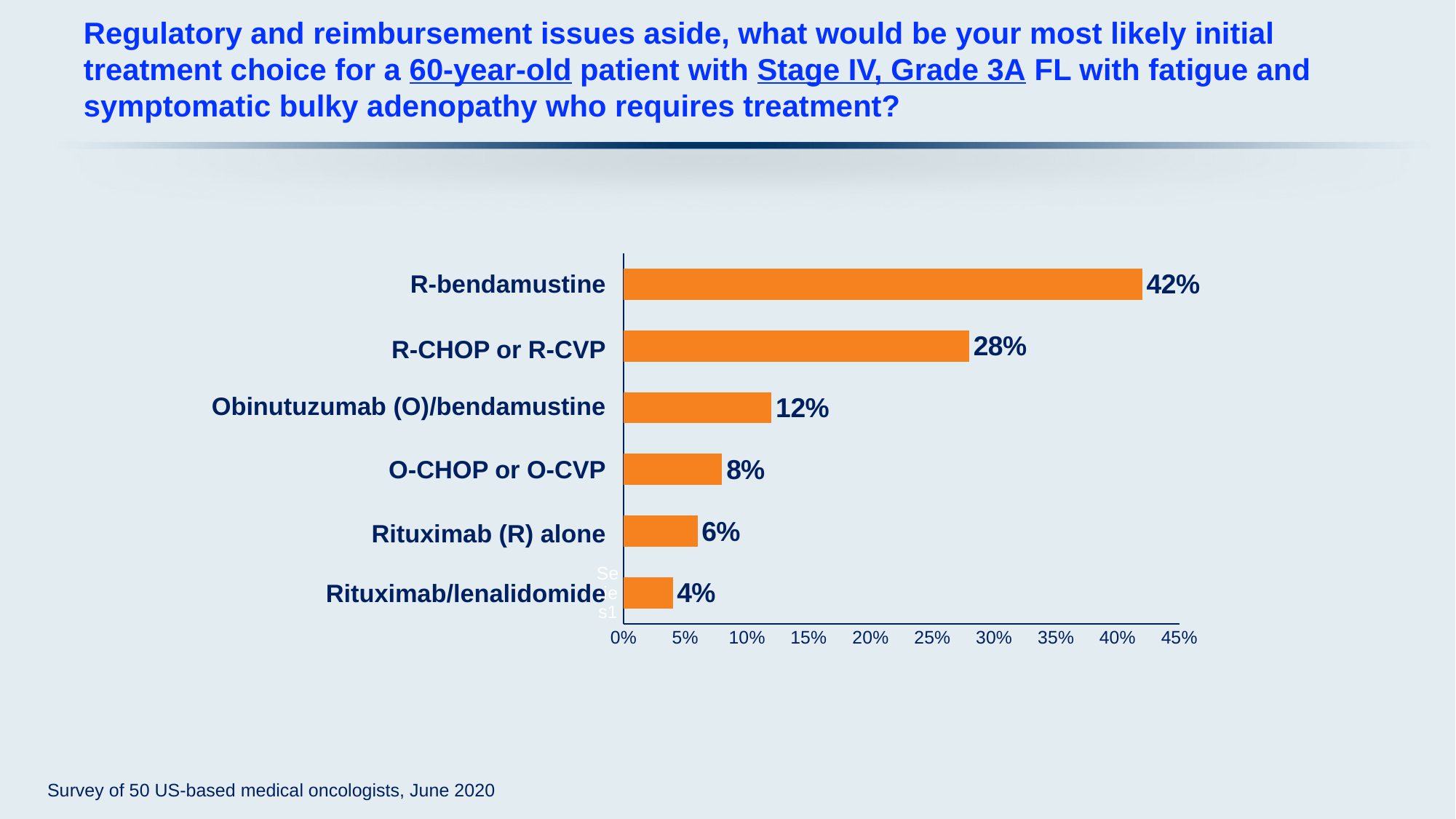
What percentage of respondents chose R-bendamustine? 42% Which treatment option has the highest percentage? R-bendamustine Is the value for R-CHOP or R-CVP greater or less than 25%? greater Which is larger, the value for O-CHOP or O-CVP or the value for Rituximab (R) alone? O-CHOP or O-CVP What is the value for Rituximab/lenalidomide? 4% Which treatment option has the lowest percentage? Rituximab/lenalidomide What percentage is shown for Obinutuzumab (O)/bendamustine? 12% What colour are the bars in the chart? Orange What type of chart is shown on the slide? Bar chart What is the value for R-CHOP or R-CVP? 28% What is the difference in percentage points between R-bendamustine and R-CHOP or R-CVP? 14% How many treatment options are shown in the chart? 6